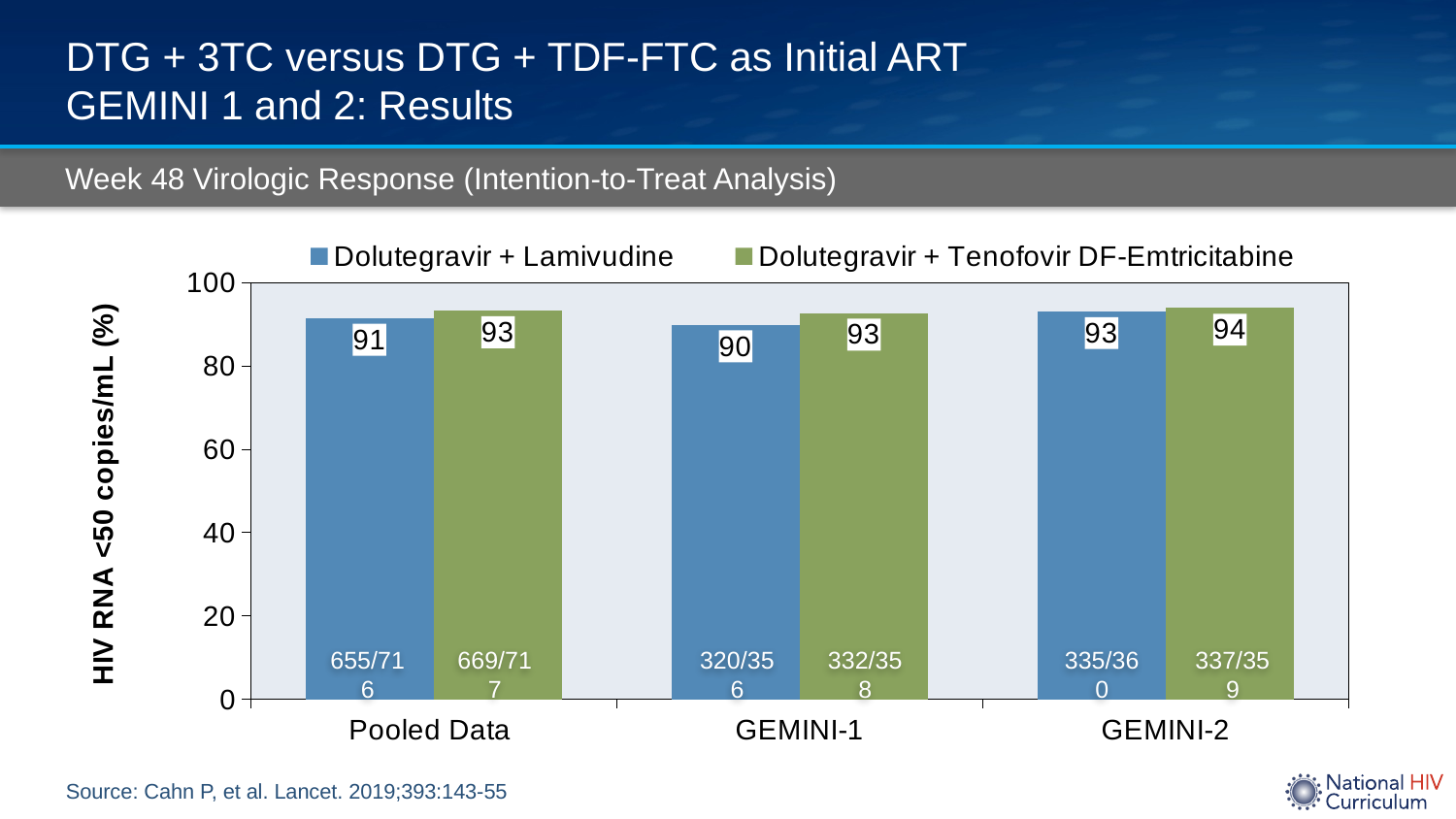
Is the value for Dolutegravir + Lamivudine in GEMINI-1 greater or less than 80? greater How many categories are shown on the x axis? 3 What is the difference between the Dolutegravir + Tenofovir DF-Emtricitabine and Dolutegravir + Lamivudine values in the GEMINI-1 category? 3 In the GEMINI-2 category, which series has the larger value? Dolutegravir + Tenofovir DF-Emtricitabine What is the value for Dolutegravir + Lamivudine in the GEMINI-2 category? 93 What is the difference between the two series' values in the Pooled Data category? 2 What is the value for Dolutegravir + Lamivudine in the Pooled Data category? 91 What is the value for Dolutegravir + Tenofovir DF-Emtricitabine in the GEMINI-1 category? 93 How many series does the legend list? 2 What is the value for Dolutegravir + Tenofovir DF-Emtricitabine in the GEMINI-2 category? 94 What kind of chart is shown on the slide? Bar chart Which category has the lowest value for Dolutegravir + Lamivudine? GEMINI-1